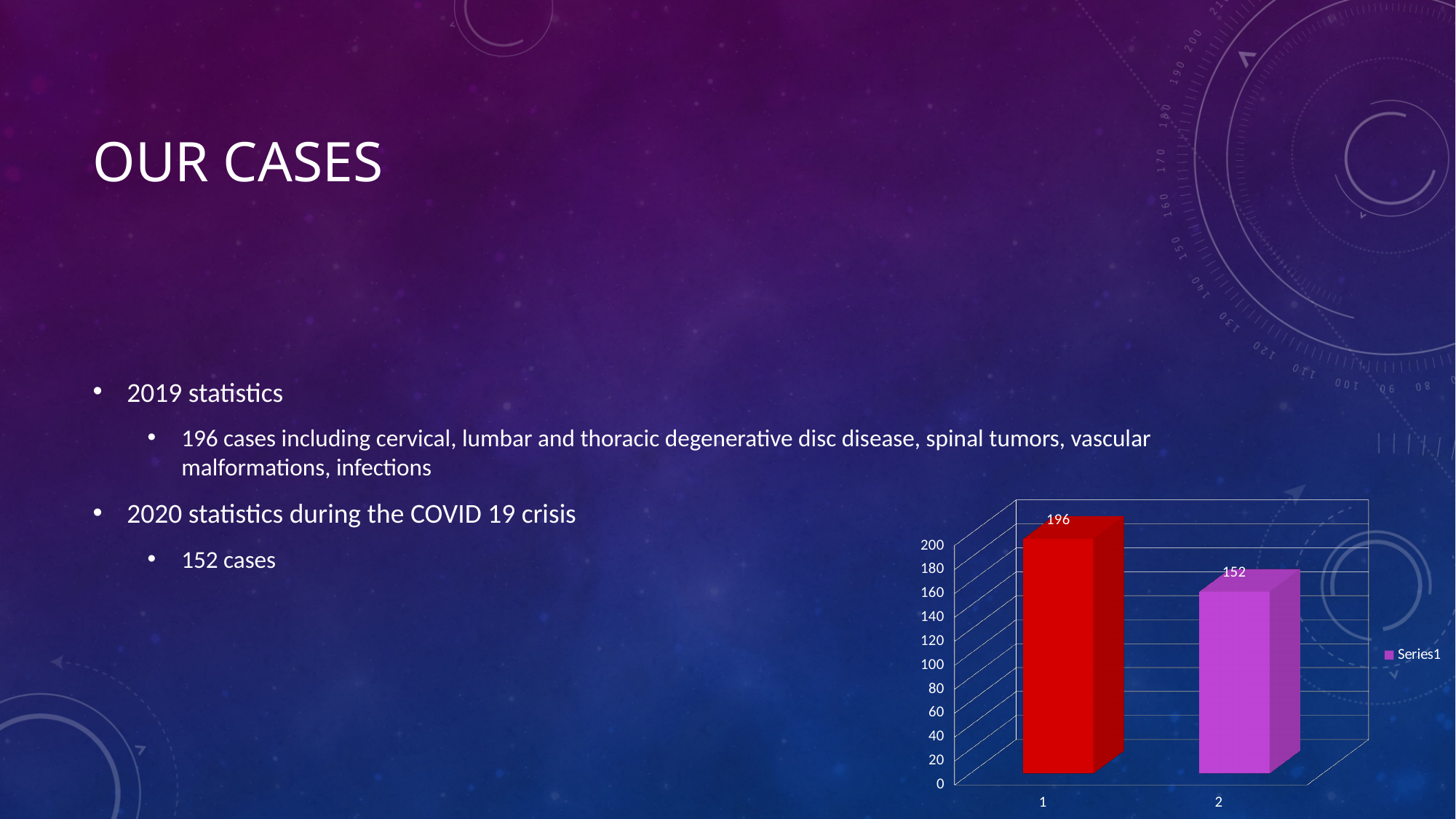
Which is larger, the value for category 1 or category 2? Category 1 Which category has the highest value? 1 What is the name of the series shown in the legend? Series1 How many series does the legend list? 1 What is the value of the bar for category 1? 196 Is the value for category 1 greater or less than 180? greater How many bars are shown in the chart? 2 Is the value for category 2 greater or less than 160? less What is the difference between the values for category 1 and category 2? 44 What is the value of the bar for category 2? 152 Which category has the lowest value? 2 What kind of chart is shown on the slide? Bar chart